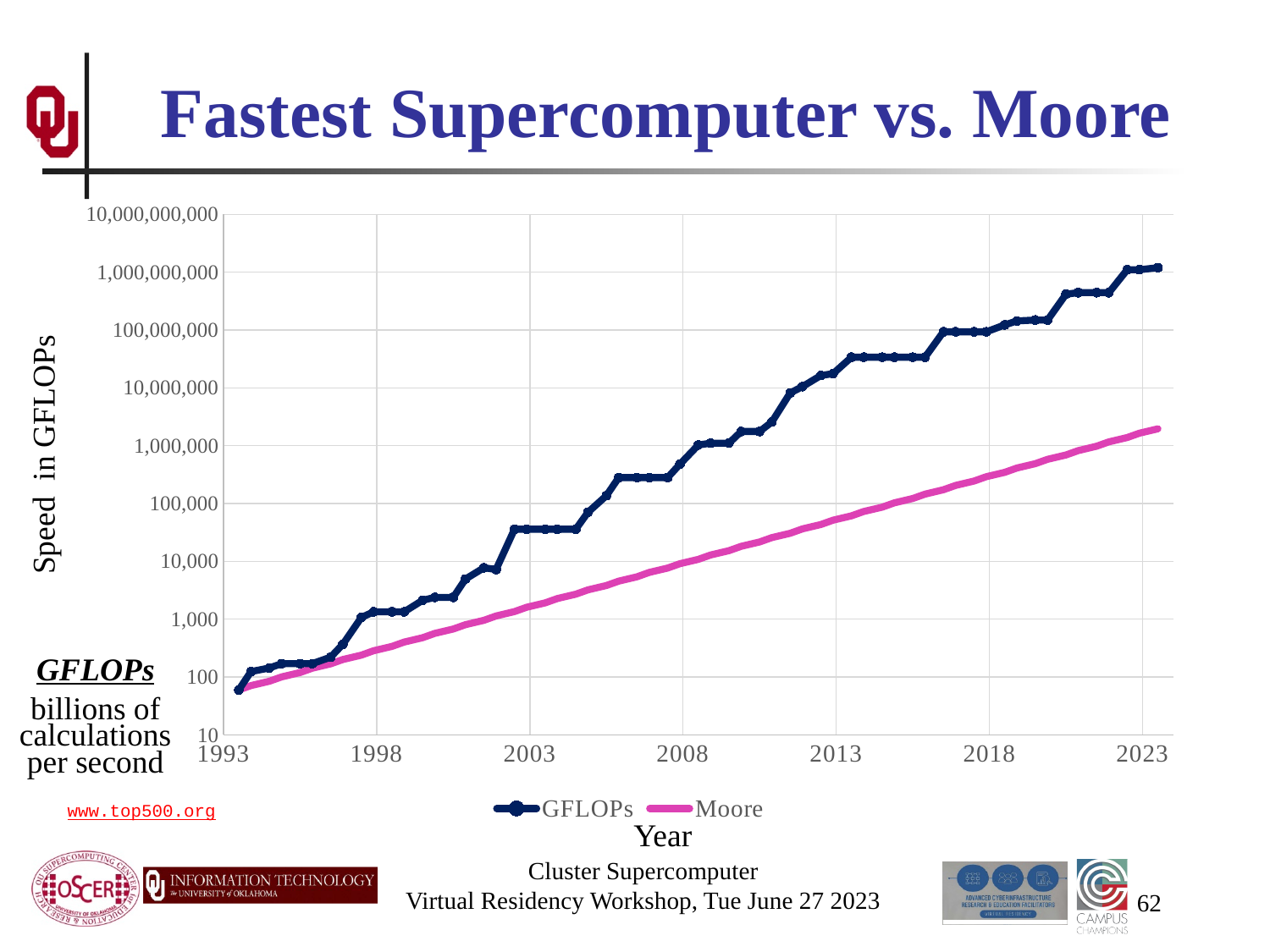
Does the Moore line rise or fall from 1993 to 2023? rise Is the GFLOPs value in 2023 greater or less than 100,000,000? greater What is the title of the chart? Fastest Supercomputer vs. Moore In 2023, which series has the higher value, GFLOPs or Moore? GFLOPs Does the GFLOPs line rise or fall from 1993 to 2023? rise What kind of chart is shown on the slide? line chart What are the two series named in the legend? GFLOPs and Moore Is the Moore value in 2023 greater or less than 10,000,000? less In 2013, which series has the higher value, GFLOPs or Moore? GFLOPs Is the Moore value in 2023 greater or less than 1,000,000? greater How many series does the legend list? 2